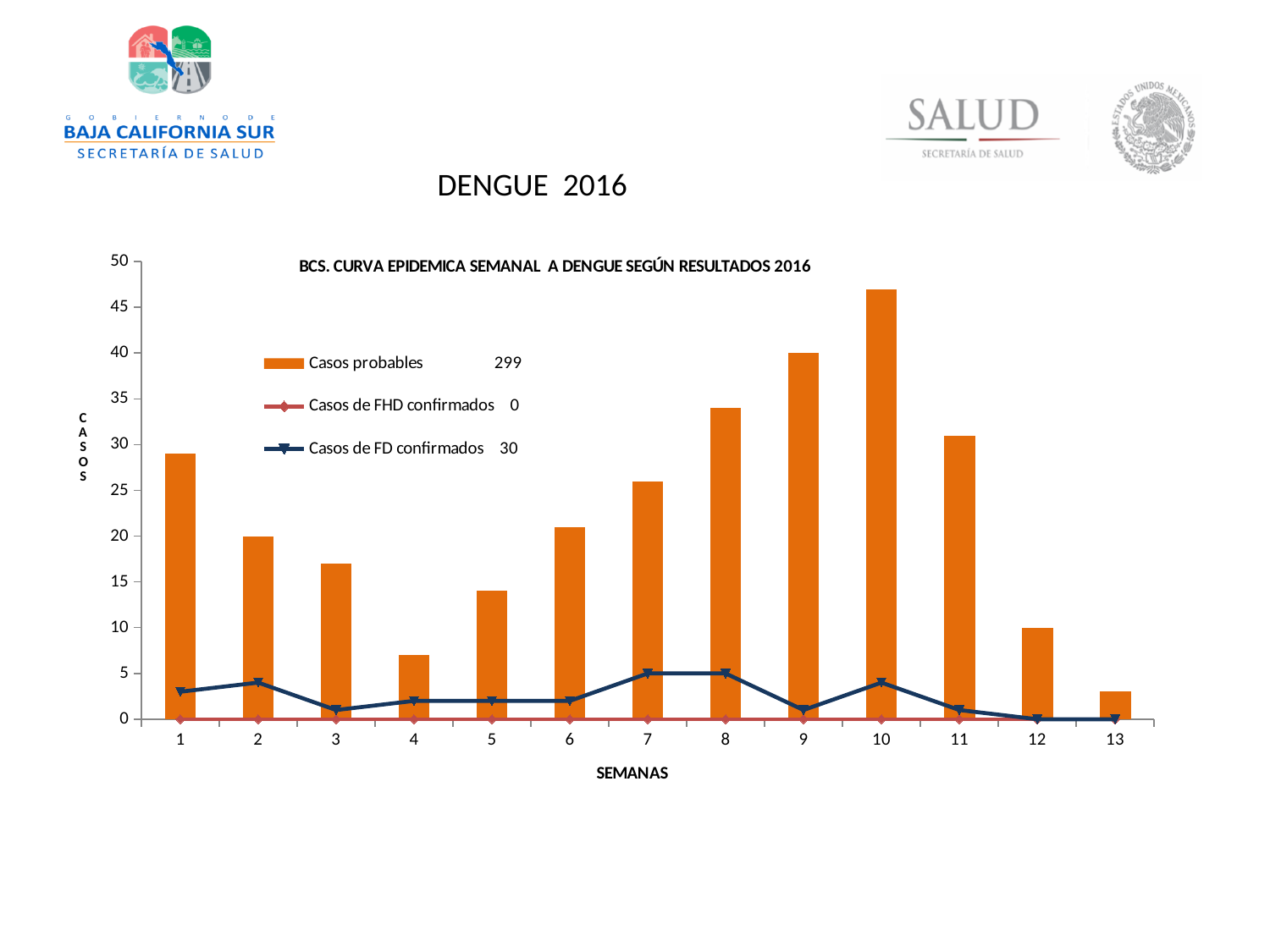
In which week is the number of Casos probables lowest? 13 In which week is the number of Casos probables highest? 10 Do the Casos probables rise or fall from week 10 to week 13? fall What kind of chart is used to show the Casos probables series? bar chart How many series does the legend list? 3 What total is shown next to Casos de FD confirmados in the legend? 30 Is the value of Casos probables in week 1 greater or less than 25? greater What total is shown next to Casos probables in the legend? 299 How many weeks (semanas) are shown on the x axis? 13 Which week has more Casos probables, week 8 or week 9? 9 Is the value of Casos probables in week 10 greater or less than 45? greater Is the value of Casos probables in week 4 greater or less than 10? less